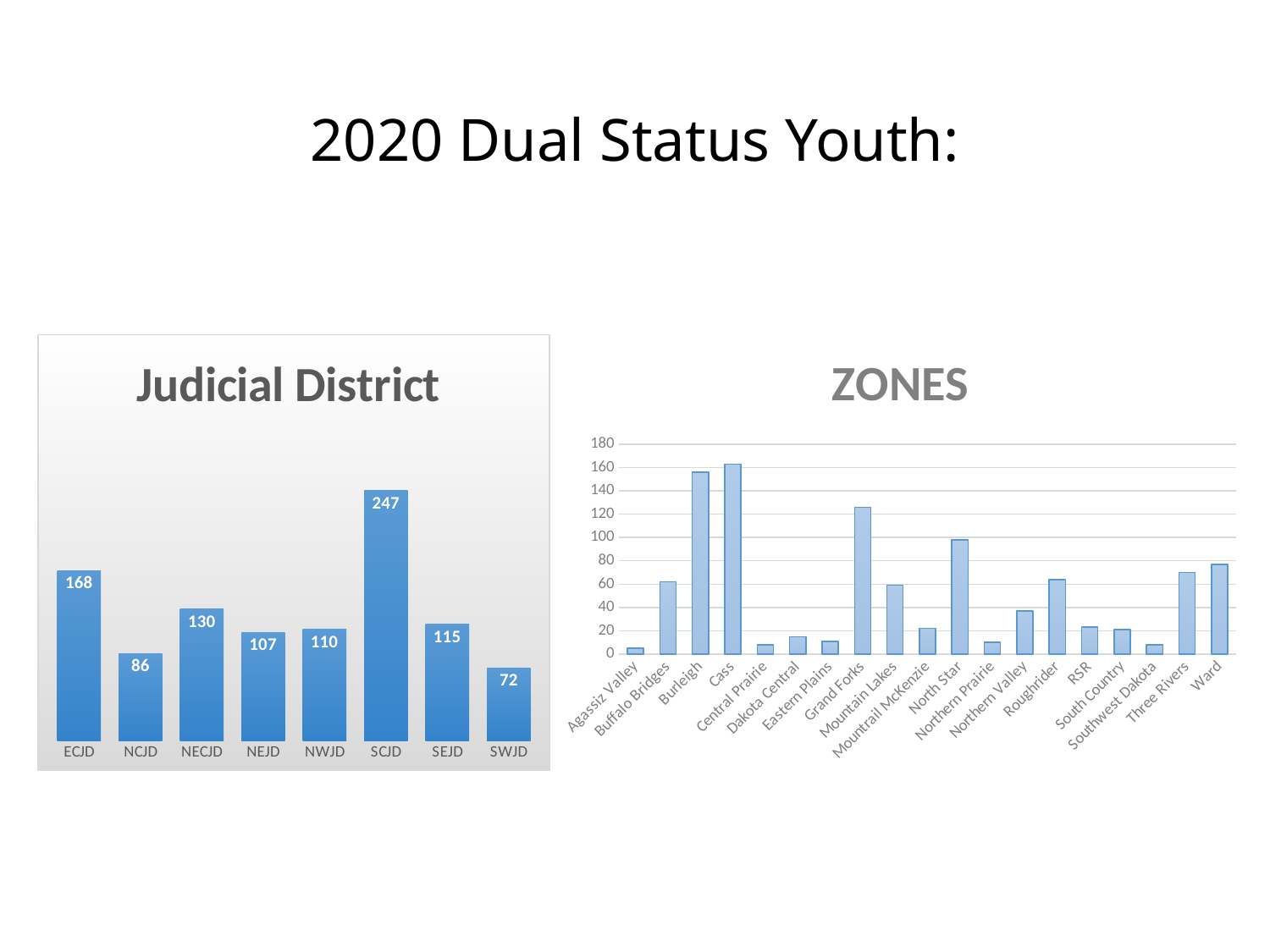
In the Judicial District chart, which is larger, the value for SEJD or the value for NWJD? SEJD In the ZONES chart, is the value for Agassiz Valley greater or less than 20? less How many districts are shown in the Judicial District chart? 8 In the ZONES chart, is the value for Burleigh greater or less than 140? greater In the Judicial District chart, which district has the lowest value? SWJD What kind of chart is the ZONES chart? bar chart How many zones are shown in the ZONES chart? 19 In the Judicial District chart, what is the difference between the values for ECJD and NCJD? 82 In the Judicial District chart, which district has the highest value? SCJD In the Judicial District chart, what is the value for SCJD? 247 In the Judicial District chart, what is the value for NECJD? 130 In the ZONES chart, is the value for Grand Forks greater or less than 100? greater